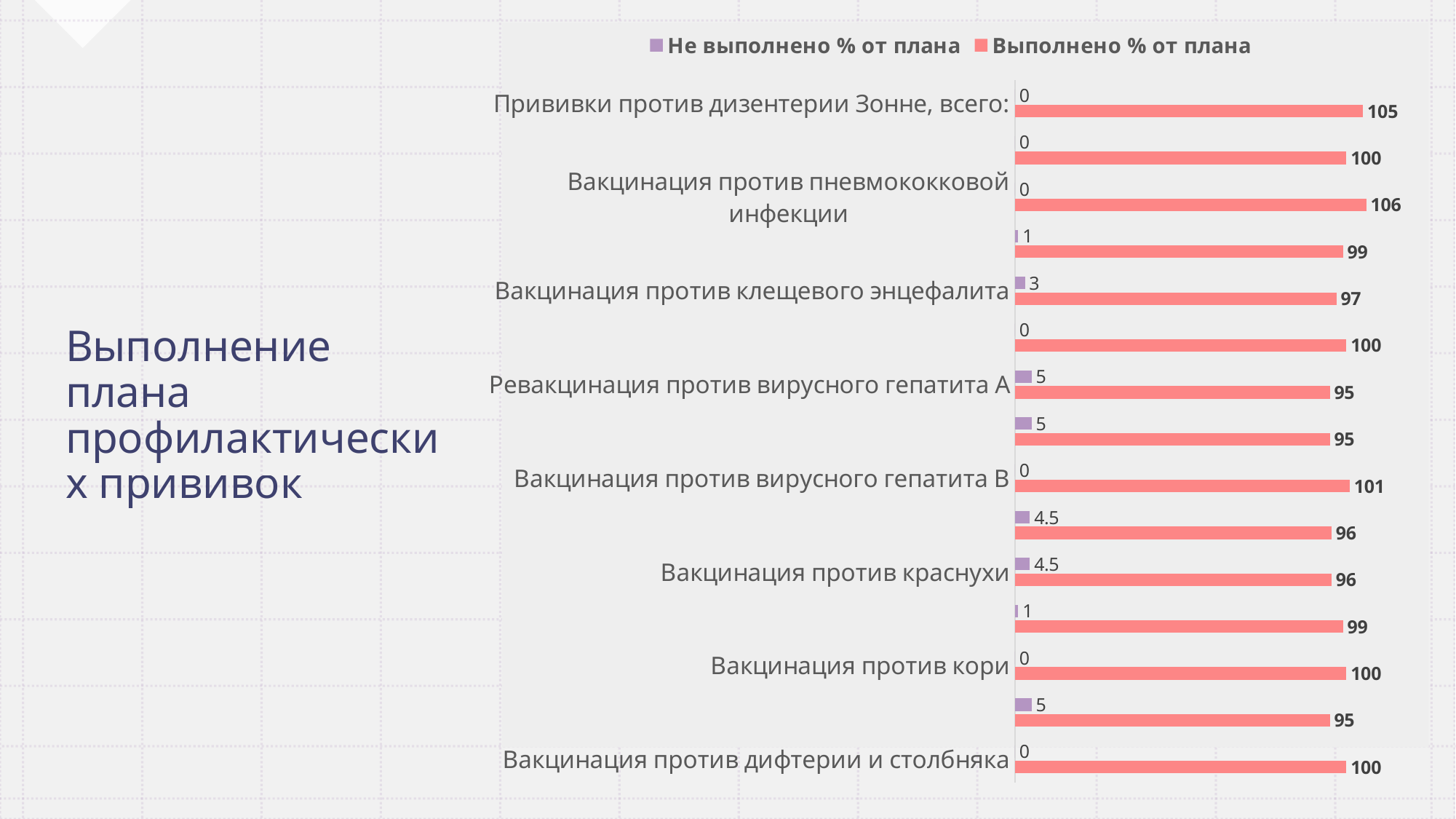
What is the value of 'Не выполнено % от плана' for 'Ревакцинация против вирусного гепатита А'? 5 How many series does the legend list? 2 Which category has the highest 'Выполнено % от плана' value? Вакцинация против пневмококковой инфекции What is the difference between the 'Выполнено % от плана' values for 'Вакцинация против пневмококковой инфекции' and 'Ревакцинация против вирусного гепатита А'? 11 What is the value of 'Не выполнено % от плана' for 'Вакцинация против краснухи'? 4.5 What is the value of 'Выполнено % от плана' for 'Вакцинация против вирусного гепатита В'? 101 What is the value of 'Не выполнено % от плана' for 'Вакцинация против клещевого энцефалита'? 3 What is the value of 'Выполнено % от плана' for 'Вакцинация против пневмококковой инфекции'? 106 What kind of chart is shown on the slide? bar chart Which has a larger 'Выполнено % от плана' value: 'Вакцинация против клещевого энцефалита' or 'Вакцинация против кори'? Вакцинация против кори What is the value of 'Выполнено % от плана' for 'Прививки против дизентерии Зонне, всего:'? 105 What colour are the bars for the 'Не выполнено % от плана' series? purple